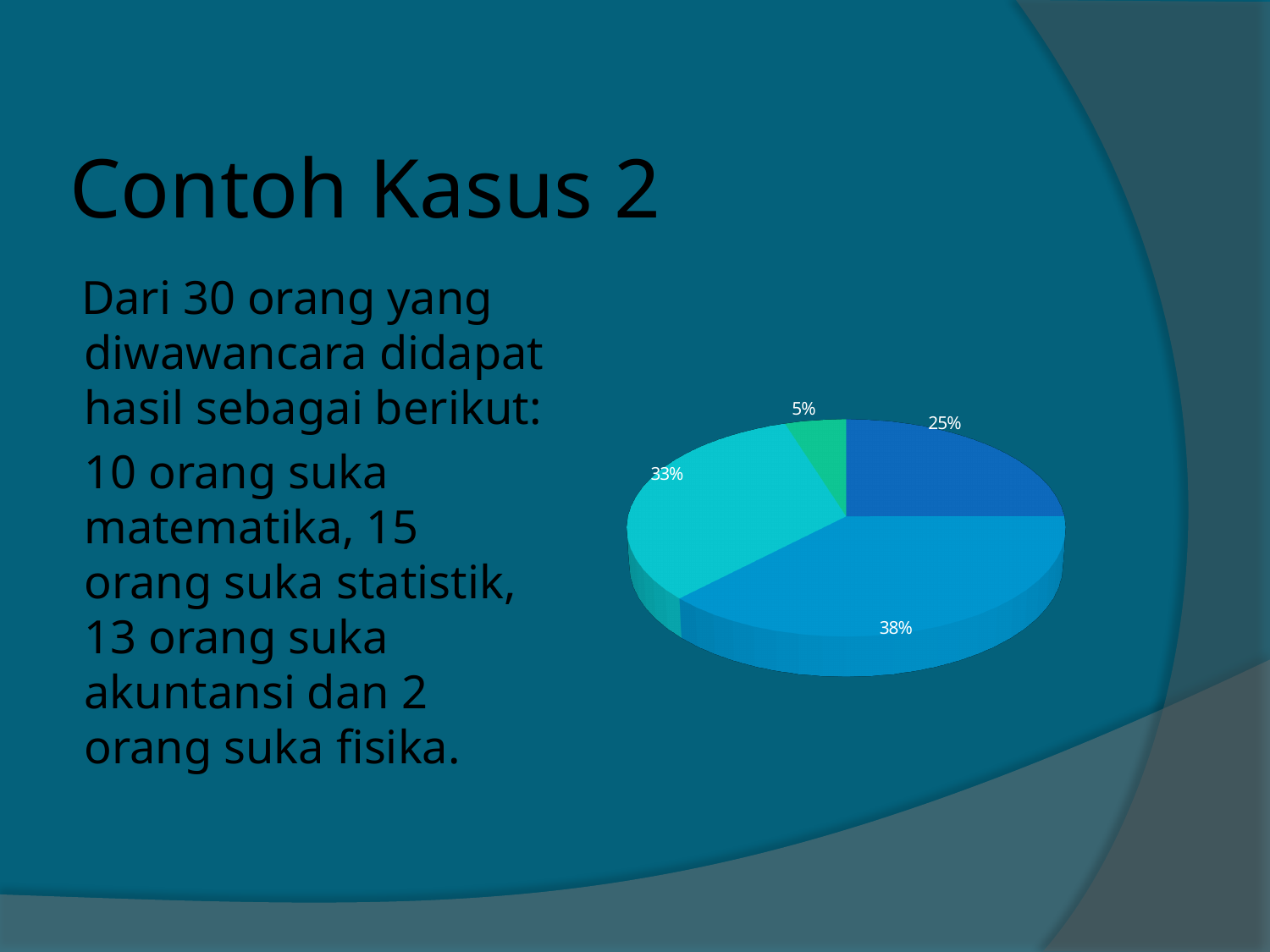
What percentage is labelled on the large slice at the bottom of the pie chart? 38% What is the largest percentage labelled on the pie chart? 38% How many slices does the pie chart have? 4 What is the difference in percentage points between the 38% slice and the 25% slice? 13 Which is larger, the slice labelled 33% or the slice labelled 25%? 33% What kind of chart is shown on the slide? Pie chart What is the smallest percentage labelled on the pie chart? 5% What percentage is labelled on the dark blue slice at the top right of the pie chart? 25% What percentage is labelled on the light teal slice on the left of the pie chart? 33% Does the pie chart display a legend? No What percentage is labelled on the small green slice of the pie chart? 5% What is the difference in percentage points between the largest slice (38%) and the smallest slice (5%)? 33